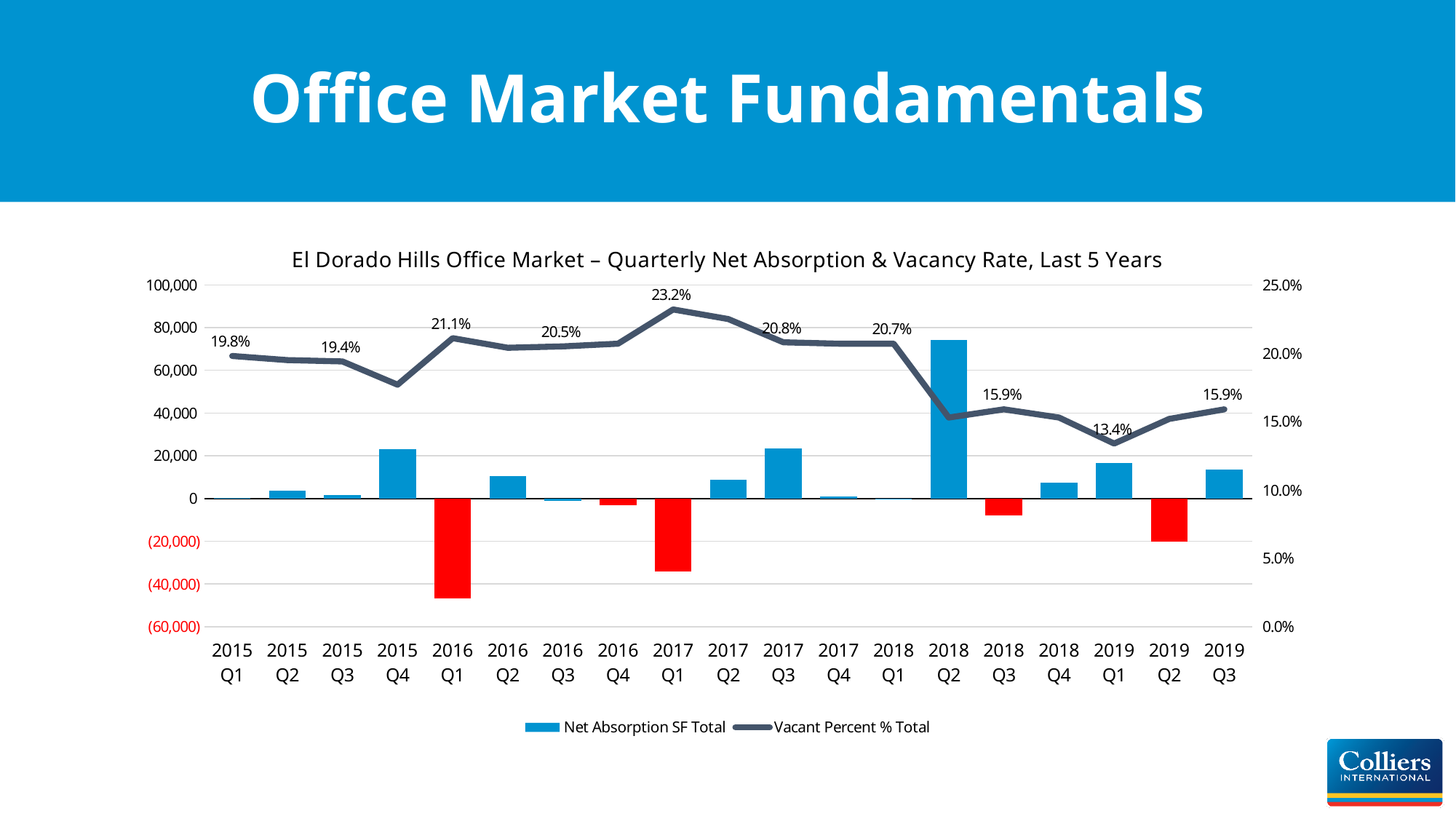
How many series does the legend list? 2 How many quarters are shown on the x axis? 19 In which quarter is the net absorption bar the tallest? 2018 Q2 What is the vacancy rate shown for 2015 Q1? 19.8% Is the net absorption value for 2016 Q1 greater or less than (40,000)? less Is the net absorption value for 2018 Q2 greater or less than 60,000? greater What is the difference between the vacancy rate in 2017 Q1 and in 2019 Q1? 9.8 percentage points What is the vacancy rate shown for 2019 Q1? 13.4% In which quarter is the labelled vacancy rate highest? 2017 Q1 What is the vacancy rate shown for 2017 Q1? 23.2% Which quarter has the higher vacancy rate, 2016 Q1 or 2015 Q3? 2016 Q1 In which quarter is the labelled vacancy rate lowest? 2019 Q1